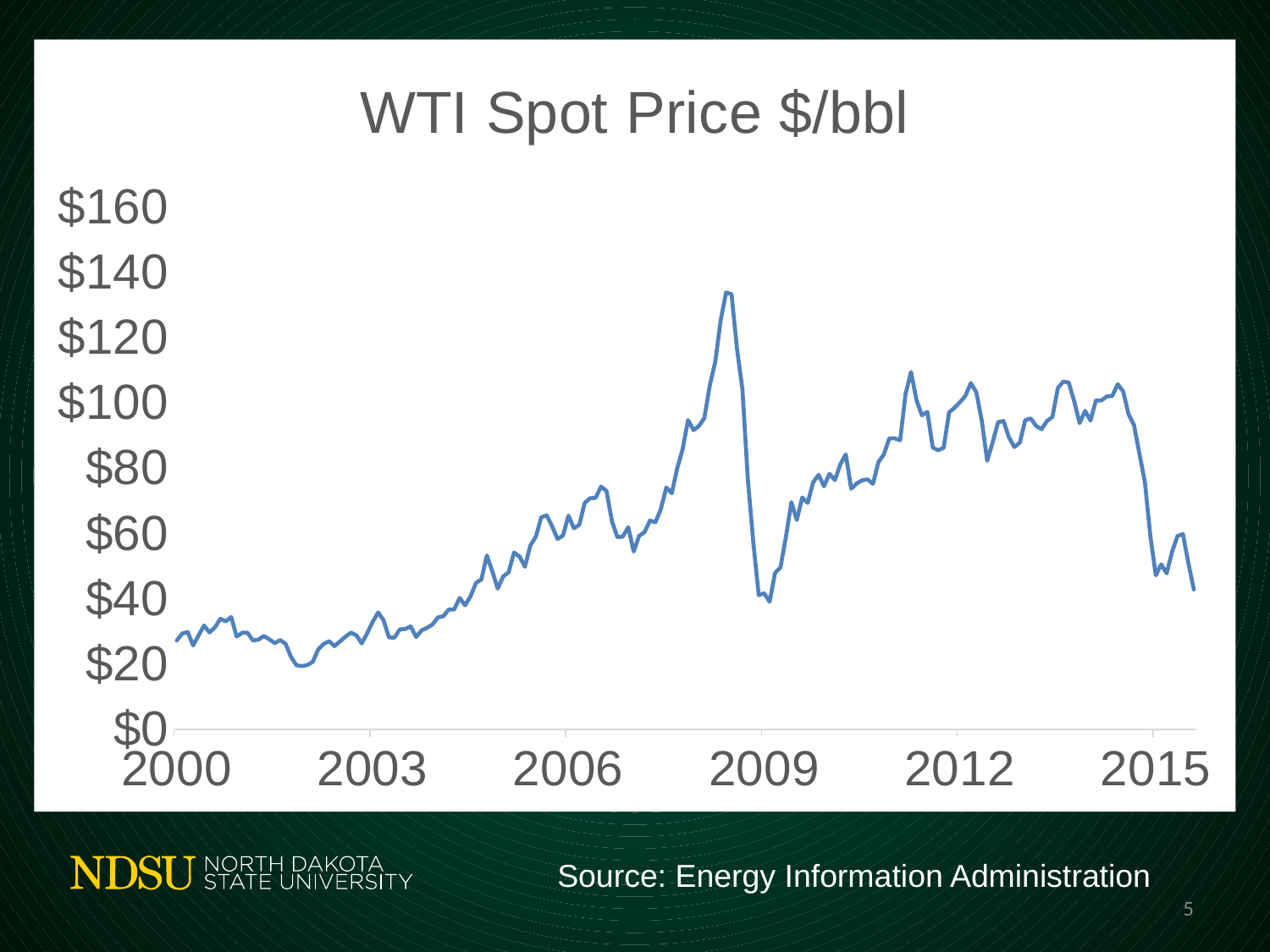
What source is cited for the chart data? Energy Information Administration Is the WTI spot price at the start of 2000 greater or less than $40? less Does the WTI spot price generally rise or fall between 2003 and 2008? rise Is the WTI spot price at the end of the series in 2015 greater or less than $60? less What kind of chart is shown on the slide? line chart Is the WTI spot price at the start of 2006 greater or less than $40? greater Does the WTI spot price rise or fall from mid-2014 to 2015? fall In which year does the WTI spot price reach its highest point? 2008 What is the title of the chart? WTI Spot Price $/bbl How many year labels are shown on the x axis? 6